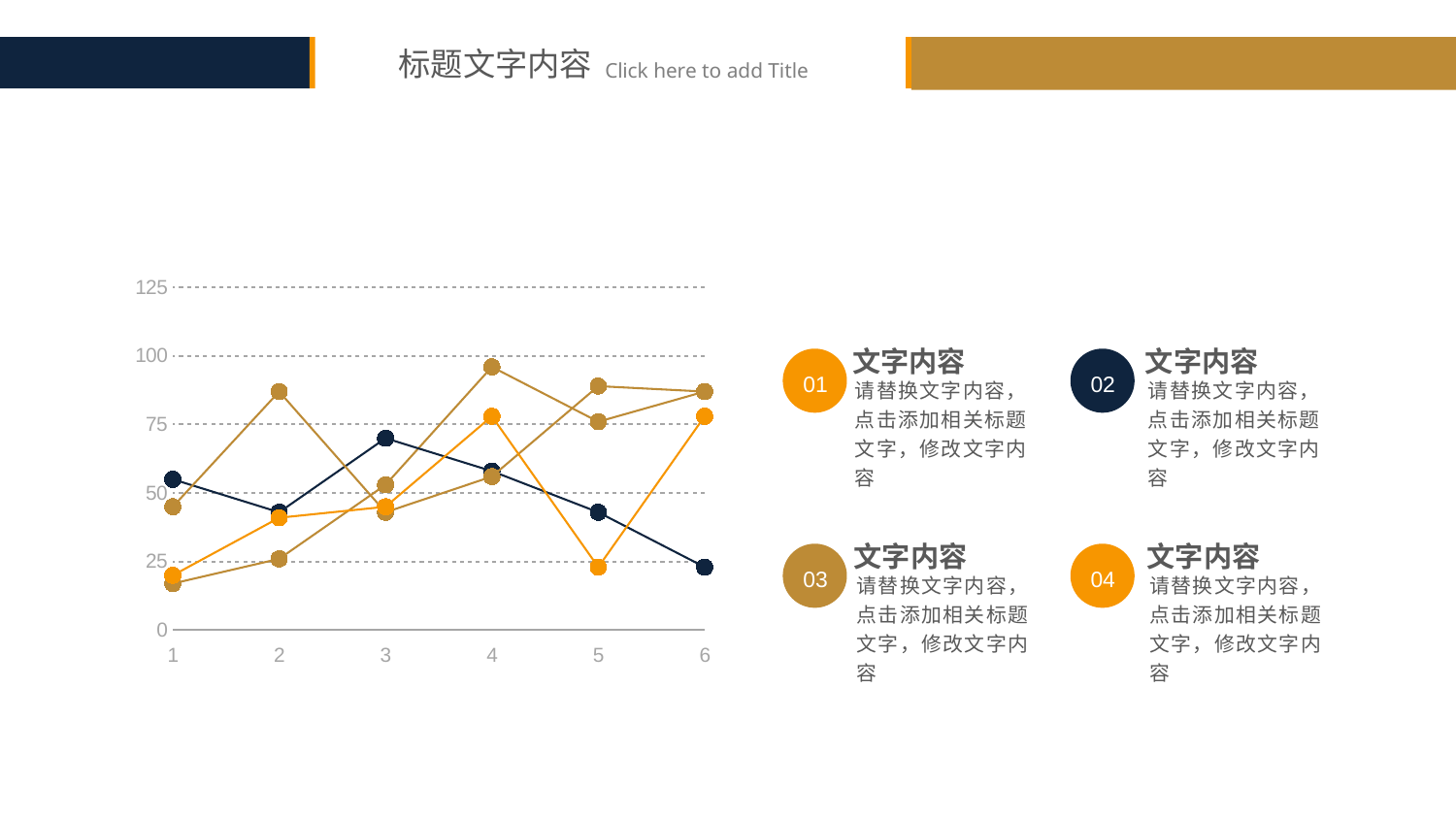
At x = 3, which line has the larger value, the dark navy line or the orange line? the dark navy line Is the value of the orange line at x = 1 greater or less than 25? less At x = 6, which line has the larger value, the dark navy line or the orange line? the orange line Is the value of the orange line at x = 5 greater or less than 50? less Is the value of the orange line at x = 4 greater or less than 50? greater What is the highest value shown on the y axis of the chart? 125 How many points are on the x axis of the line chart? 6 Does the dark navy line rise or fall from x = 4 to x = 6? fall How many lines are plotted on the chart? 4 What kind of chart is shown on the slide? line chart